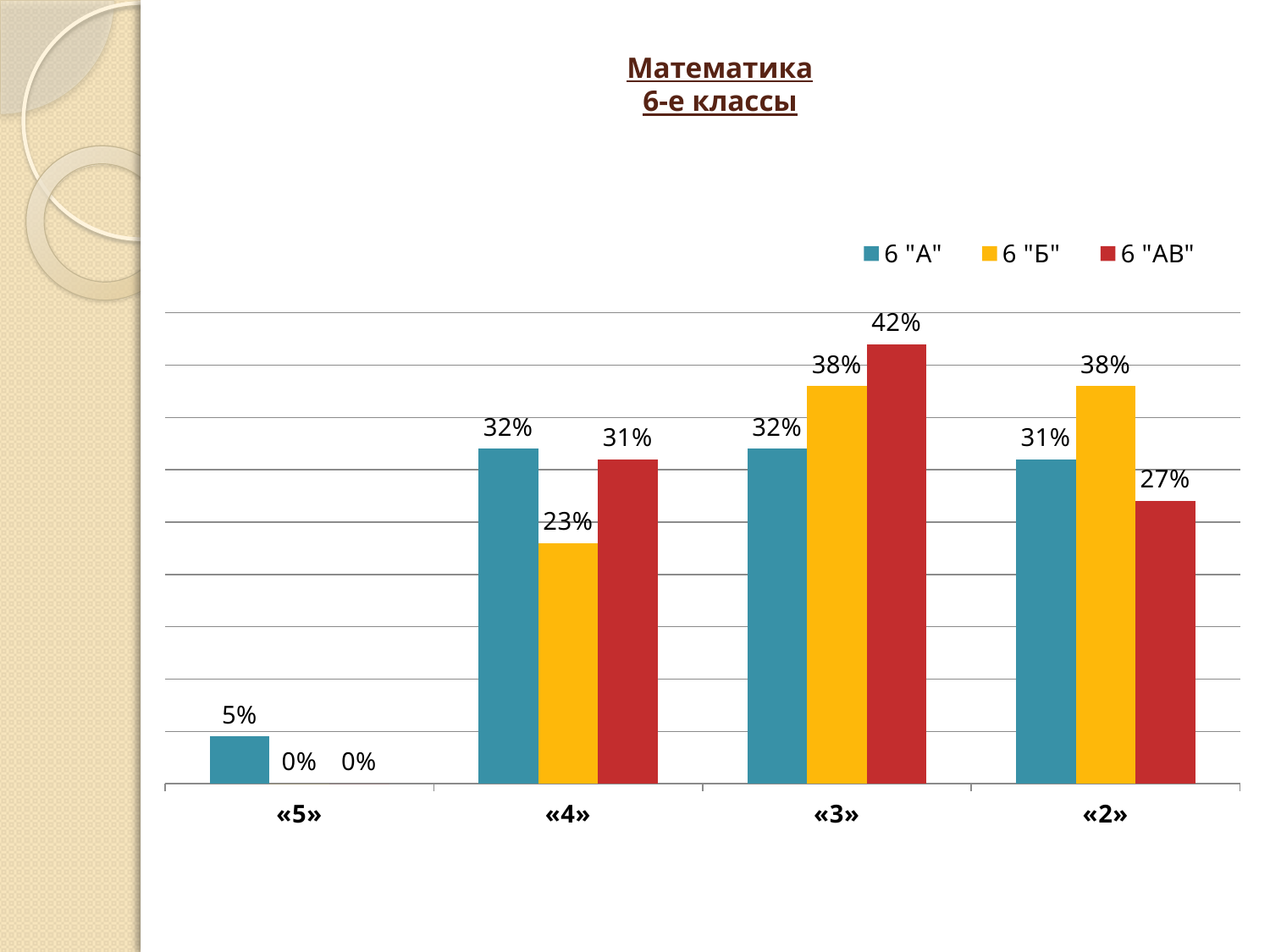
What is the value for 6 "А" in the «5» category? 5% What kind of chart is shown on the slide? bar chart What is the value for 6 "АВ" in the «3» category? 42% What is the value for 6 "АВ" in the «2» category? 27% Which category has the lowest value for 6 "А"? «5» What is the difference between the 6 "Б" and 6 "АВ" values in the «2» category? 11% What is the value for 6 "Б" in the «4» category? 23% What is the title of the slide? Математика 6-е классы In the «4» category, which is larger: 6 "А" or 6 "Б"? 6 "А" How many series does the legend list? 3 How many categories are shown on the x axis? 4 Which category has the highest value for 6 "АВ"? «3»